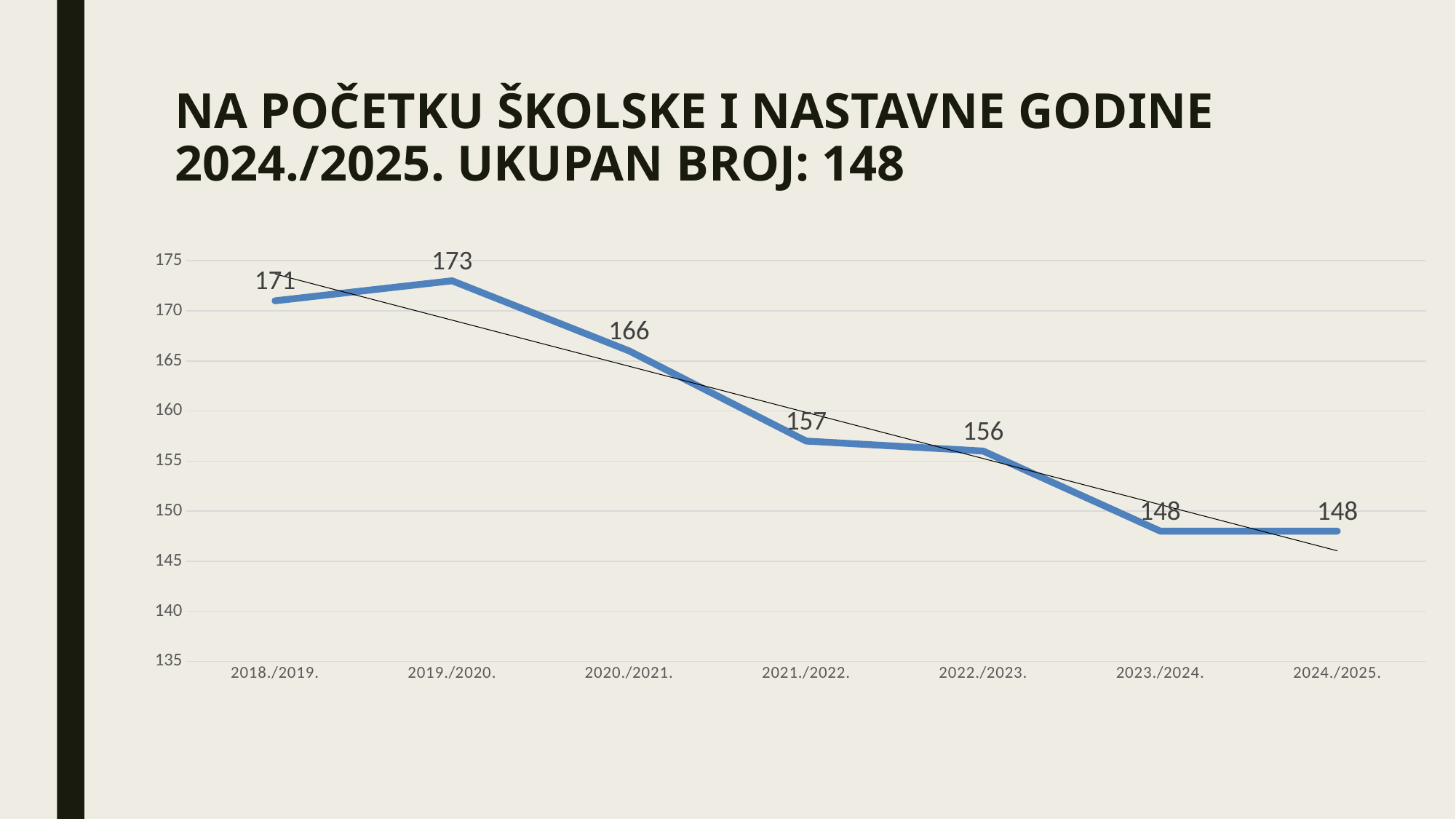
What kind of chart is shown on the slide? line chart How many school years are plotted on the chart? 7 What is the difference between the values for 2020./2021. and 2021./2022.? 9 Which is larger, the value for 2018./2019. or the value for 2022./2023.? 2018./2019. What is the value for 2019./2020.? 173 Which school year has the highest value? 2019./2020. Do the values generally rise or fall from 2019./2020. to 2024./2025.? fall What is the value for 2018./2019.? 171 Is the value for 2020./2021. greater or less than 160? greater What is the value for 2024./2025.? 148 What is the difference between the values for 2019./2020. and 2024./2025.? 25 What is the value for 2021./2022.? 157